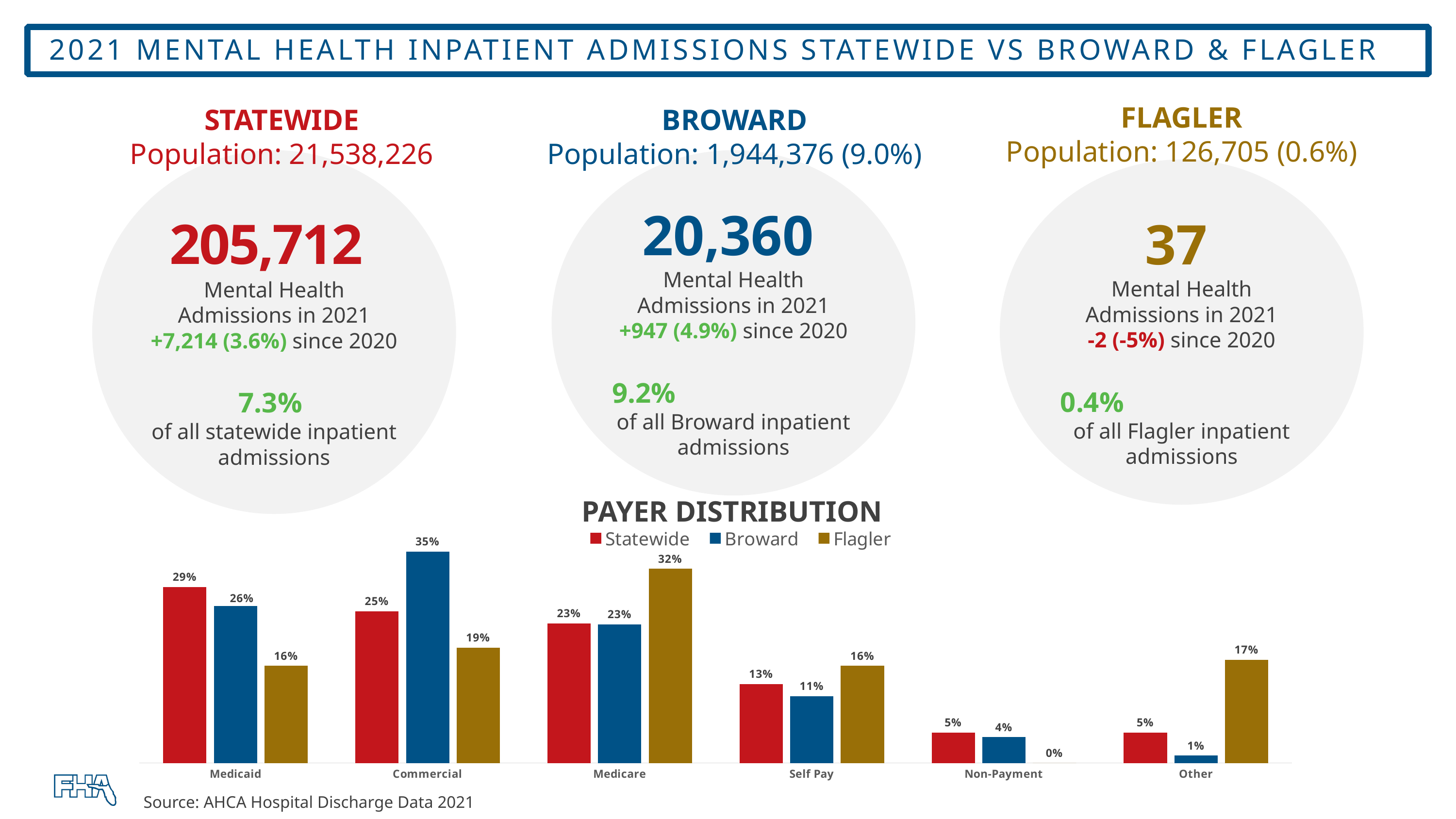
In the Payer Distribution chart, what is the Statewide value for Medicaid? 29% What kind of chart is the Payer Distribution chart? Bar chart In the Payer Distribution chart, which is larger for Self Pay: the Statewide value or the Flagler value? Flagler In the Payer Distribution chart, which payer category has the highest Broward value? Commercial How many series does the legend of the Payer Distribution chart list? 3 In the Payer Distribution chart, what is the difference between the Flagler and Broward values for Other? 16% In the Payer Distribution chart, which payer category has the lowest Statewide value? Non-Payment and Other (both 5%) In the Payer Distribution chart, what is the Broward value for Commercial? 35% In the Payer Distribution chart, which colour represents the Flagler series? Gold In the Payer Distribution chart, what is the Flagler value for Non-Payment? 0% How many payer categories are shown on the x axis of the Payer Distribution chart? 6 In the Payer Distribution chart, what is the Flagler value for Medicare? 32%